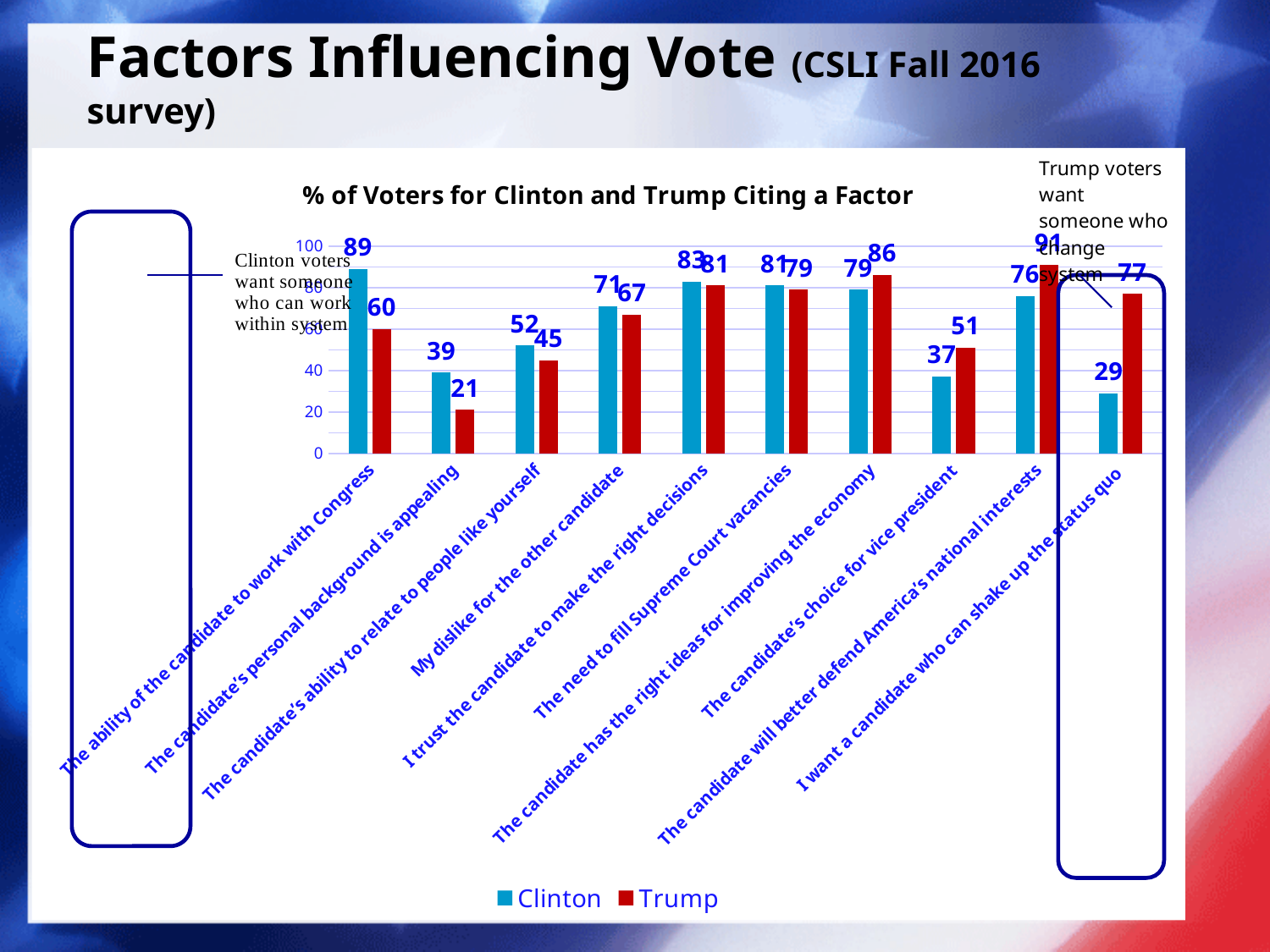
What percentage of Clinton voters cited the ability of the candidate to work with Congress? 89 What type of chart is shown on the slide? bar chart Which factor has the highest value for Trump voters? The candidate will better defend America's national interests For 'The candidate has the right ideas for improving the economy', which series has the larger value, Clinton or Trump? Trump How many factors (categories) are shown on the x axis? 10 What is the difference between the Trump and Clinton values for 'I want a candidate who can shake up the status quo'? 48 What is the Trump value for the candidate's choice for vice president? 51 What is the difference between the Clinton and Trump values for 'The candidate's personal background is appealing'? 18 What percentage of Trump voters cited wanting a candidate who can shake up the status quo? 77 Which factor has the lowest value for Clinton voters? I want a candidate who can shake up the status quo How many series does the legend list? 2 What is the title of the chart? % of Voters for Clinton and Trump Citing a Factor